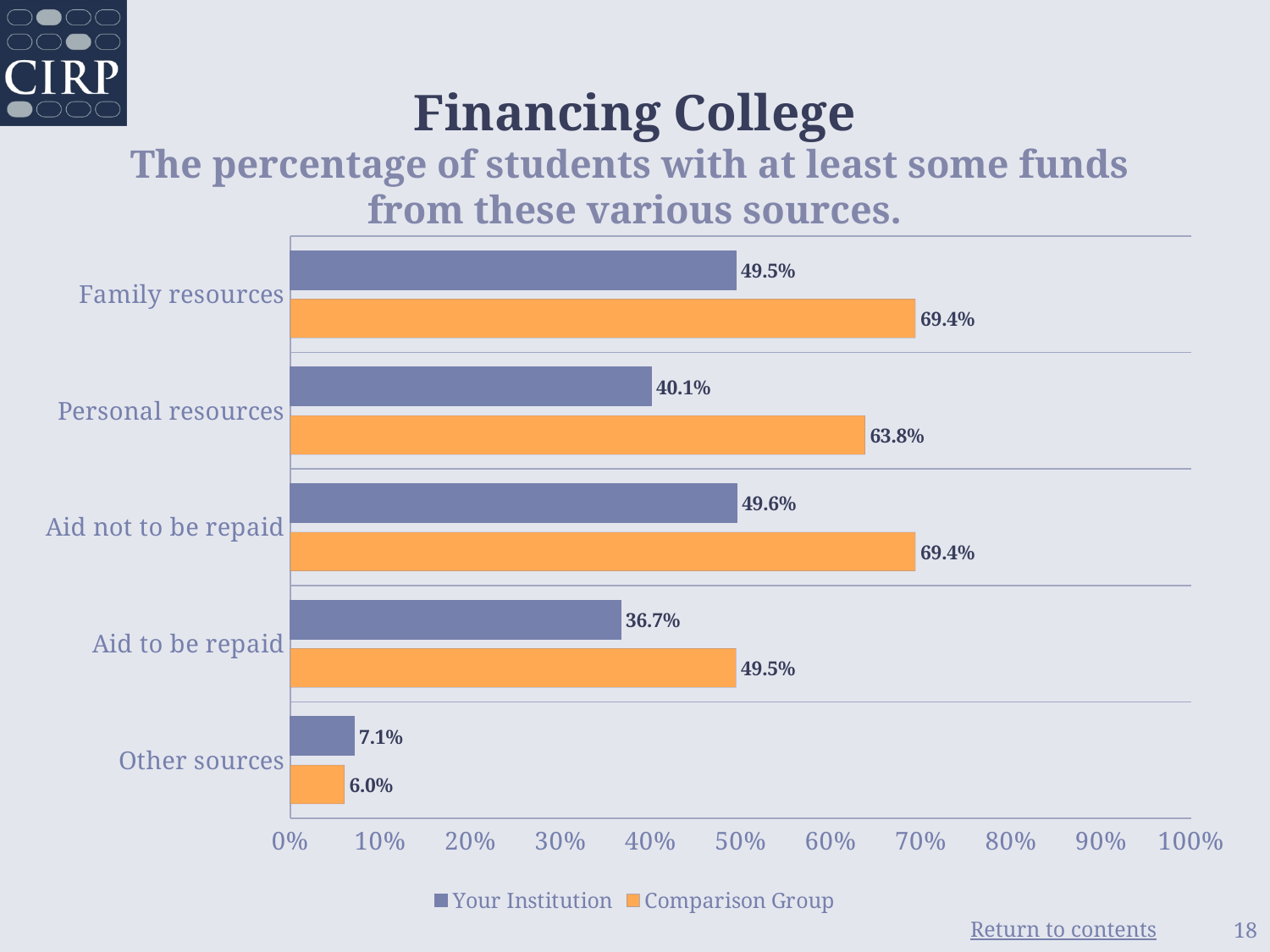
What is the value for Comparison Group for Personal resources? 63.8% What is the value for Your Institution for Other sources? 7.1% Which category has the highest value for Your Institution? Aid not to be repaid What is the value for Comparison Group for Aid to be repaid? 49.5% What is the difference between the Comparison Group and Your Institution values for Personal resources? 23.7% Which series is shown in orange? Comparison Group What kind of chart is shown on the slide? Bar chart How many categories are shown on the chart? 5 Which category has the lowest value for Comparison Group? Other sources Which is larger for Other sources: Your Institution or Comparison Group? Your Institution What is the value for Your Institution for Family resources? 49.5% How many series does the legend list? 2